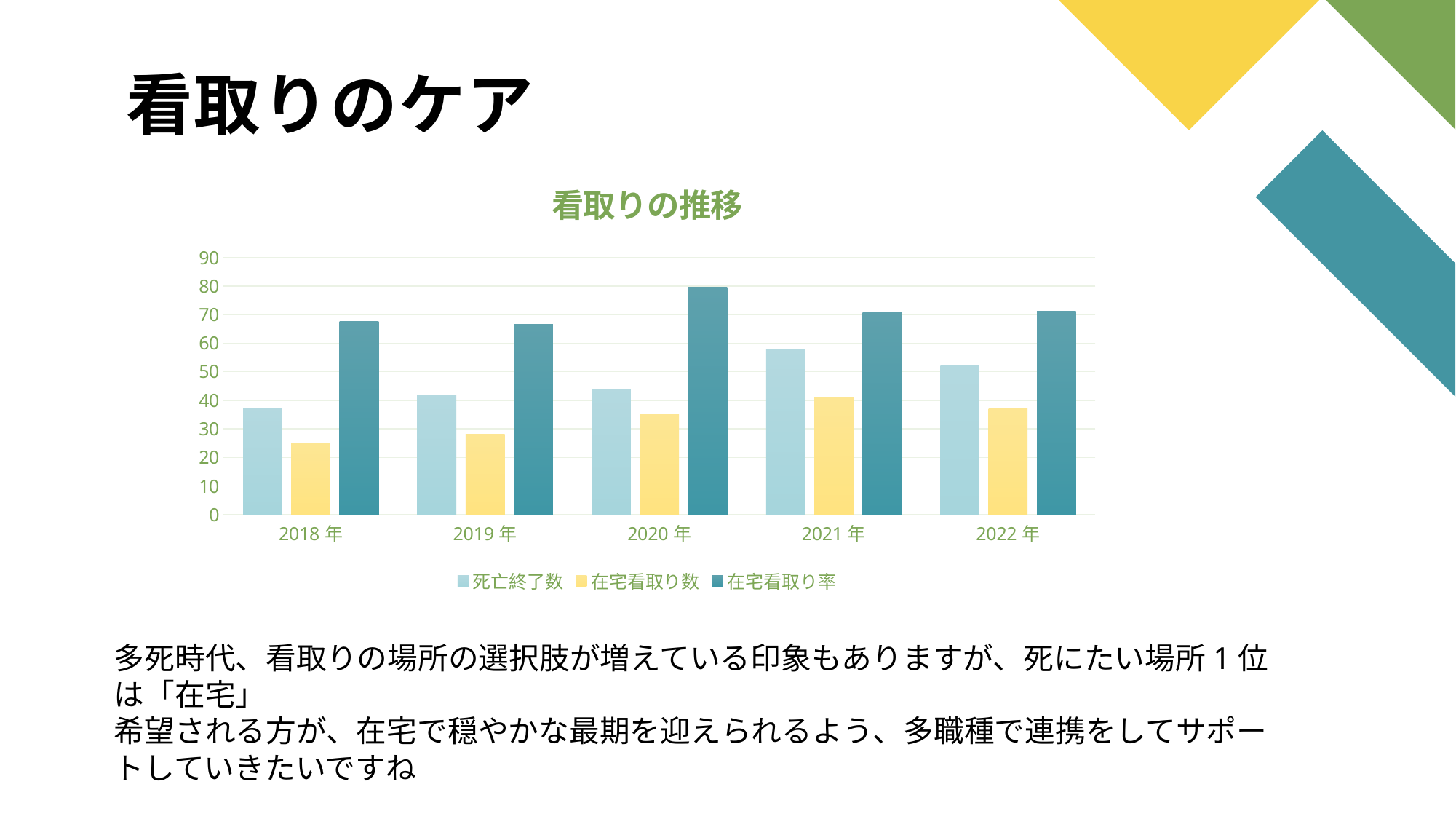
In which year is 在宅看取り率 the highest? 2020 年 What type of chart is shown on the slide? Bar chart How many years are shown on the x axis of the chart? 5 Is the value of 在宅看取り率 for 2020 年 greater or less than 70? greater What is the title of the chart? 看取りの推移 Is the value of 死亡終了数 for 2021 年 greater or less than 50? greater Which year has the larger 死亡終了数, 2021 年 or 2022 年? 2021 年 Is the value of 在宅看取り数 for 2018 年 greater or less than 30? less In which year is 死亡終了数 the highest? 2021 年 Does 在宅看取り数 rise or fall from 2018 年 to 2021 年? rise How many series does the chart legend list? 3 In which year is 在宅看取り数 the lowest? 2018 年